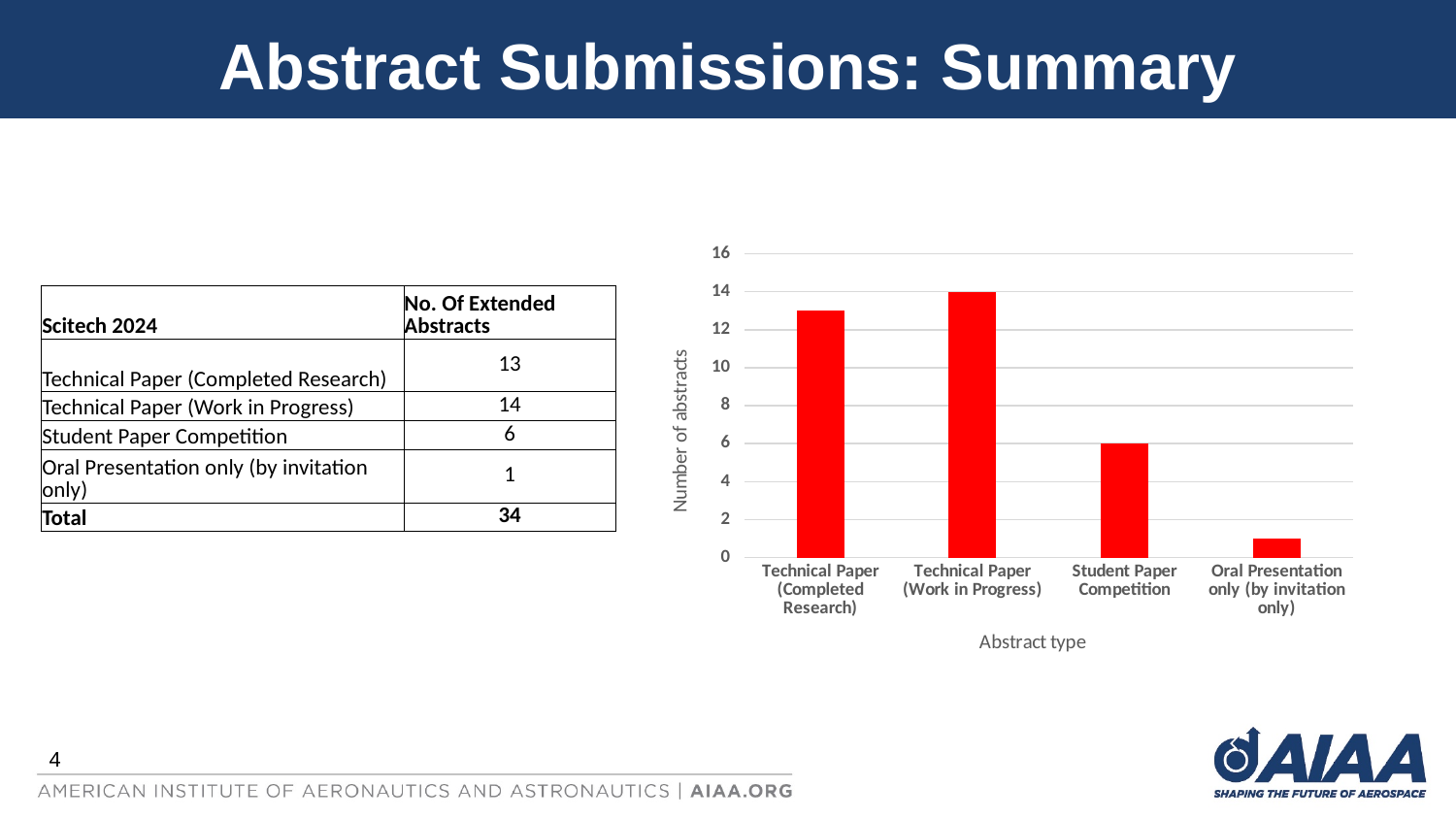
How many abstract types are plotted on the chart? 4 Which abstract type has the highest number of abstracts? Technical Paper (Work in Progress) What kind of chart is shown on the slide? bar chart Which has more abstracts, Technical Paper (Completed Research) or Student Paper Competition? Technical Paper (Completed Research) Which abstract type has the lowest number of abstracts? Oral Presentation only (by invitation only) Is the value for Technical Paper (Completed Research) greater or less than 10? greater What is the difference in number of abstracts between Technical Paper (Work in Progress) and Student Paper Competition? 8 How many abstracts were submitted for Technical Paper (Work in Progress)? 14 How many abstracts were submitted for Student Paper Competition? 6 How many abstracts were submitted for Technical Paper (Completed Research)? 13 What is the label of the vertical axis of the chart? Number of abstracts How many abstracts were submitted for Oral Presentation only (by invitation only)? 1